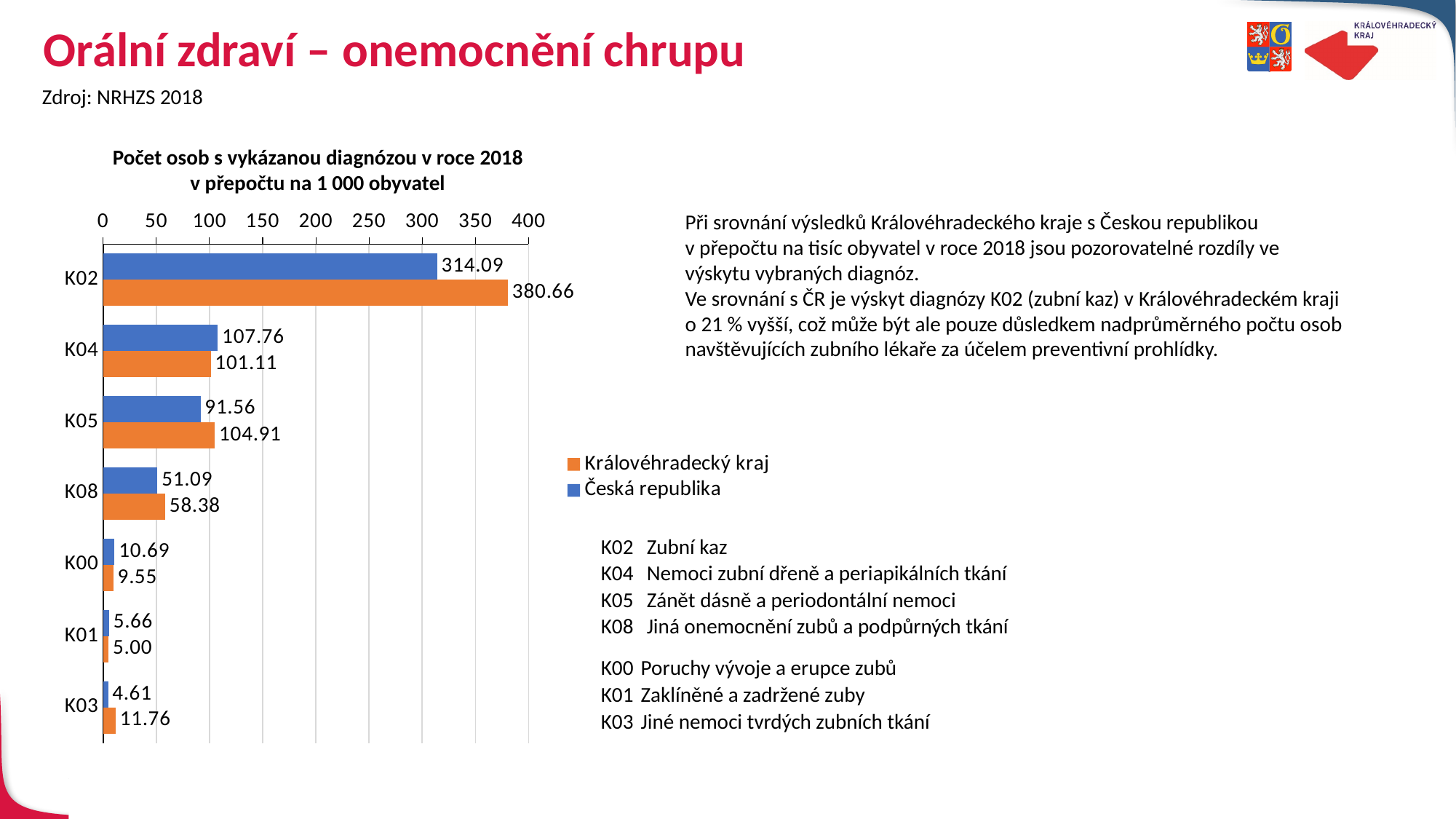
For K04, which is larger: the value for Královéhradecký kraj or for Česká republika? Česká republika What is the value for Královéhradecký kraj for K02? 380.66 How many series does the legend list? 2 Which colour represents Česká republika in the chart? blue What is the difference between the Královéhradecký kraj and Česká republika values for K02? 66.57 How many diagnosis categories are shown on the chart? 7 Which category has the highest value for Česká republika? K02 What is the value for Královéhradecký kraj for K03? 11.76 Is the value for Královéhradecký kraj for K05 greater or less than 100? greater What kind of chart is shown on the slide? bar chart Which category has the lowest value for Královéhradecký kraj? K01 What is the value for Česká republika for K05? 91.56